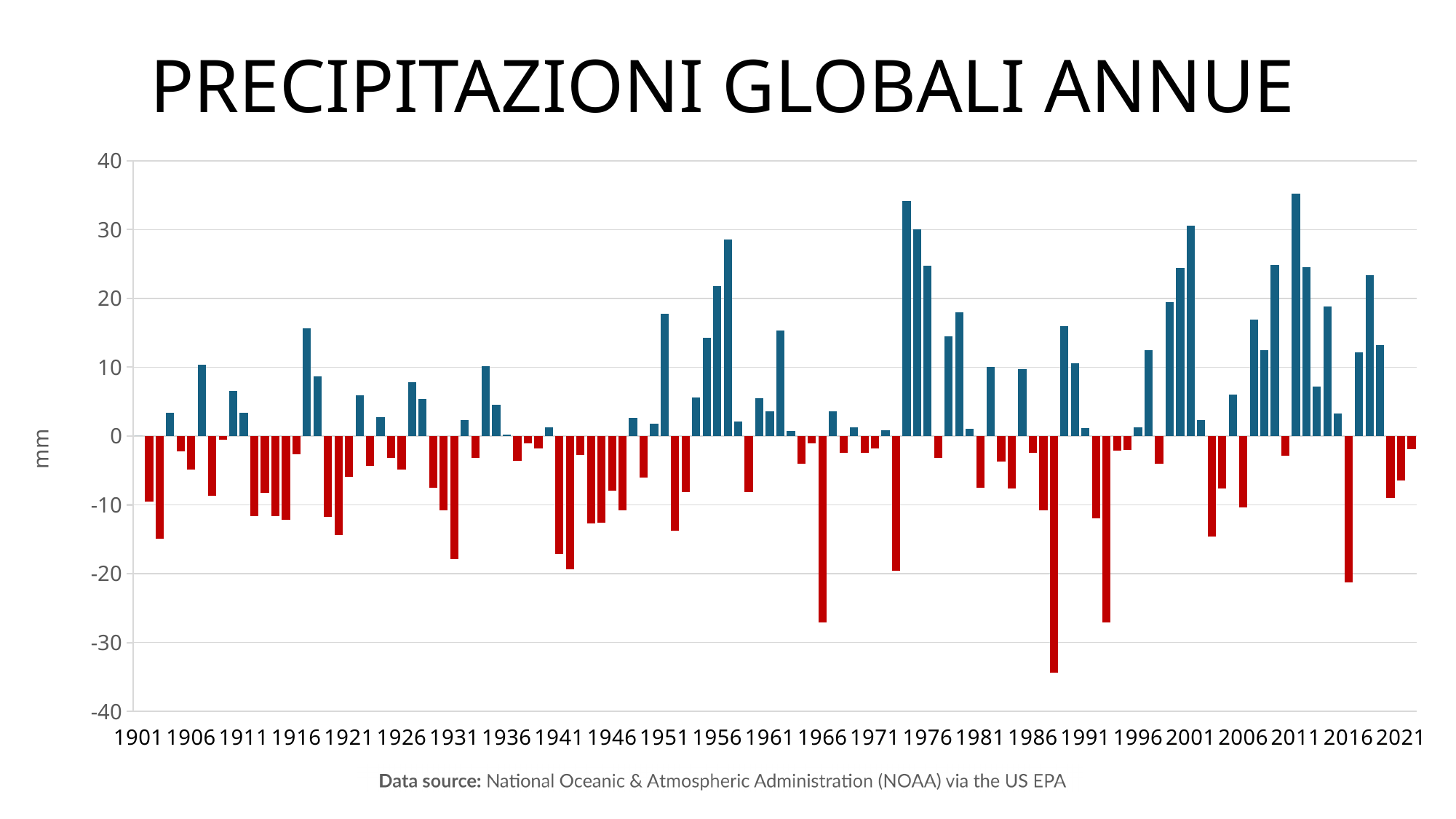
Is the lowest value on the chart greater or less than -30? less What is the title of the chart? PRECIPITAZIONI GLOBALI ANNUE Is the value for 1941 greater or less than -10? less Is the value for 2021 greater or less than 0? less What unit is shown on the vertical axis of the chart? mm What kind of chart is shown on the slide? bar chart